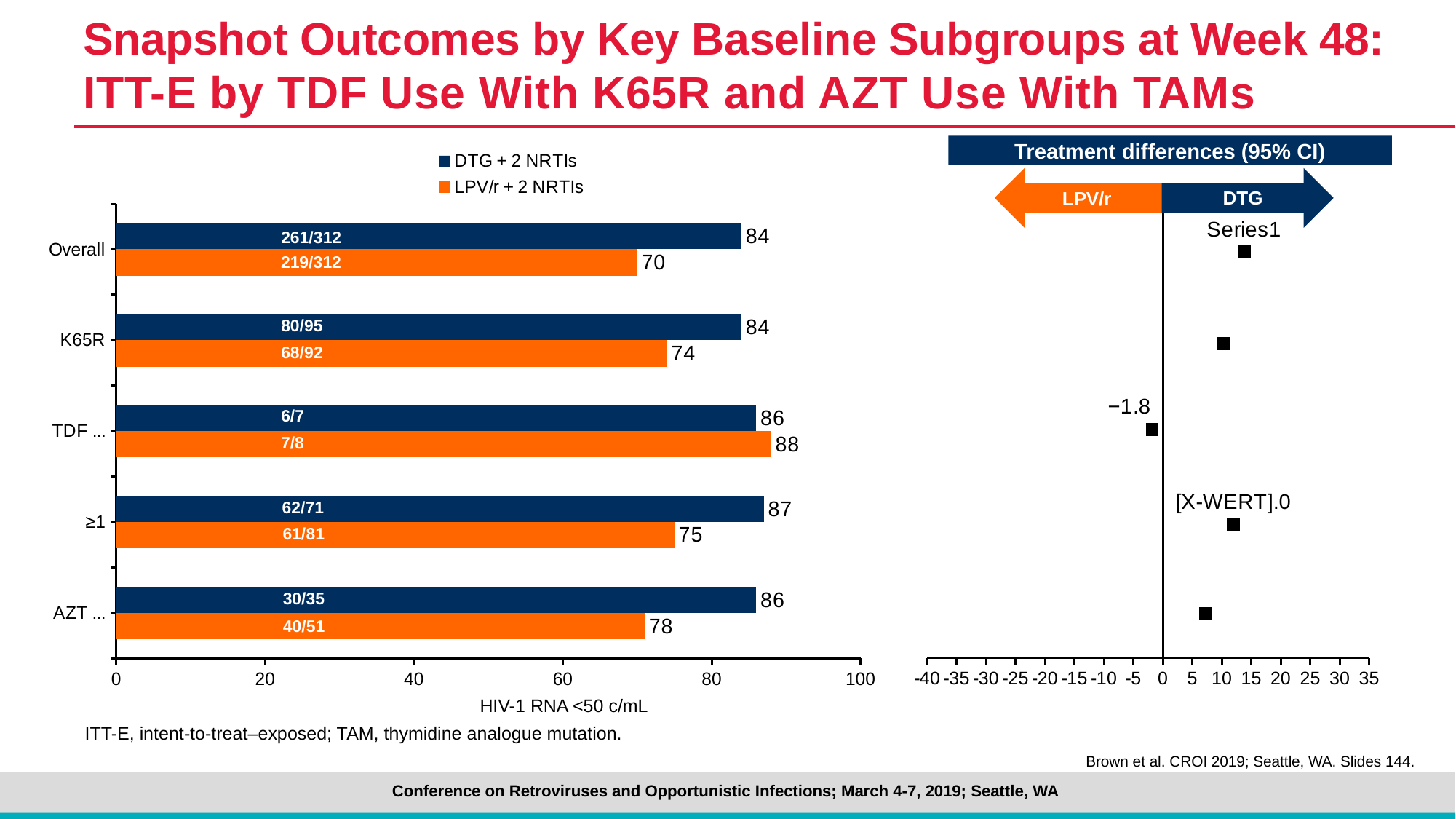
In the left bar chart, which subgroup has the highest DTG + 2 NRTIs value? ≥1 How many subgroups are shown on the left bar chart? 5 In the left bar chart, what is the difference between the DTG + 2 NRTIs and LPV/r + 2 NRTIs values in the Overall subgroup? 14 In the left bar chart, which series has the larger value in the TDF subgroup? LPV/r + 2 NRTIs In the left bar chart, what is the value for DTG + 2 NRTIs in the Overall subgroup? 84 In the left bar chart, what is the value for LPV/r + 2 NRTIs in the K65R subgroup? 74 What kind of chart is the left chart? bar chart What fraction is printed inside the DTG + 2 NRTIs bar for the Overall subgroup in the left chart? 261/312 In the left bar chart, what is the value for LPV/r + 2 NRTIs in the TDF subgroup? 88 In the left bar chart, which subgroup has the lowest LPV/r + 2 NRTIs value? Overall How many series does the legend of the left chart list? 2 In the left bar chart, which subgroup has the highest LPV/r + 2 NRTIs value? TDF ...